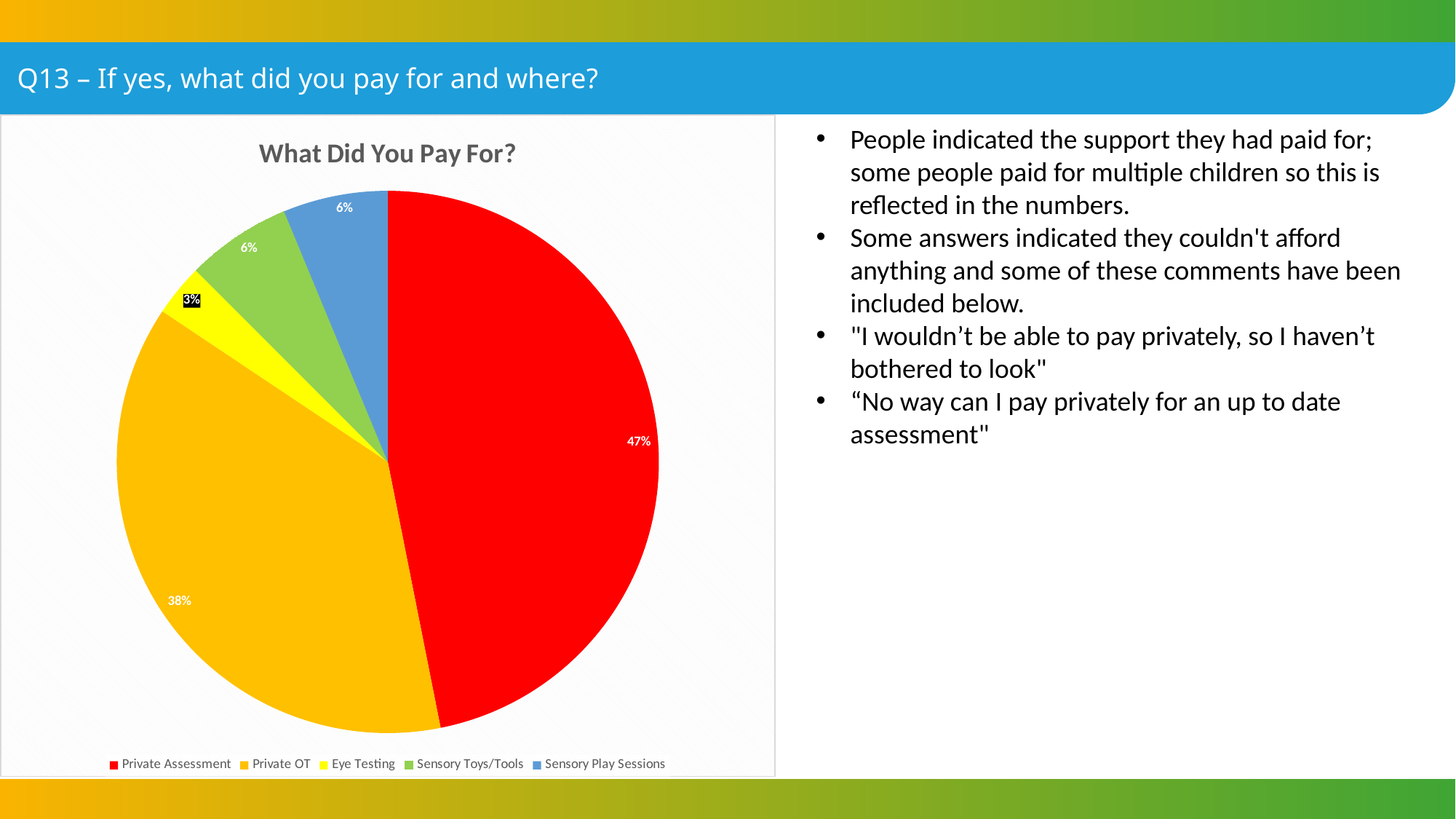
Which category has the largest slice of the pie? Private Assessment Which is larger, the share for Private OT or the share for Sensory Play Sessions? Private OT What share of the pie is Sensory Toys/Tools? 6% Which colour represents Private OT in the legend? orange What kind of chart is shown on the slide? pie chart What share of the pie is Eye Testing? 3% What is the difference in percentage points between Private Assessment and Private OT? 9 Which category has the smallest slice of the pie? Eye Testing What is the title of the chart? What Did You Pay For? What share of the pie is Private Assessment? 47% How many categories does the pie chart show? 5